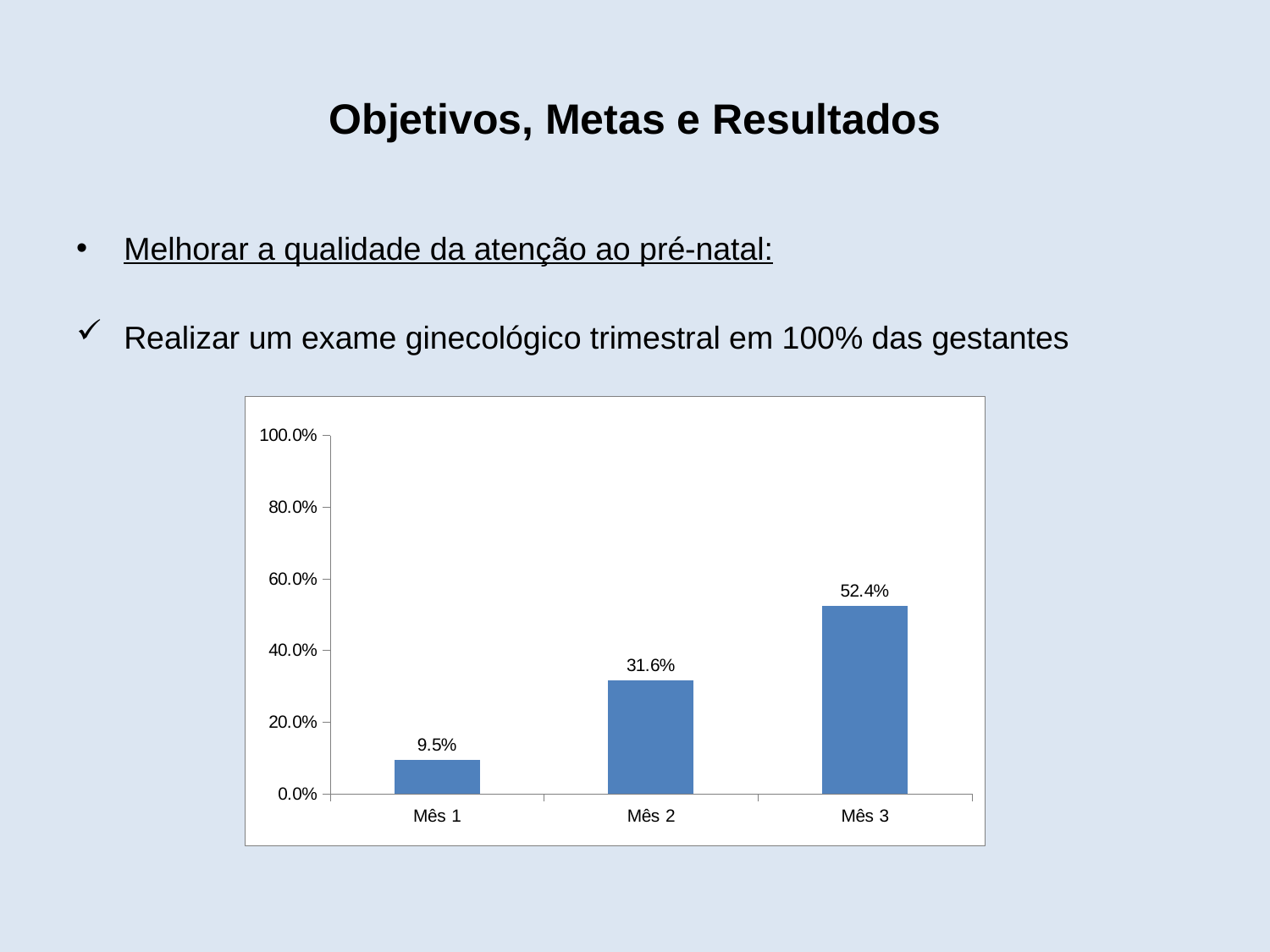
How many categories are shown on the x axis? 3 What is the difference between the values for Mês 2 and Mês 1? 22.1% Is the value for Mês 3 greater or less than 40.0%? greater Which month has the highest value? Mês 3 Do the values rise or fall from Mês 1 to Mês 3? rise What kind of chart is shown on the slide? bar chart What is the value for Mês 1? 9.5% What is the difference between the values for Mês 3 and Mês 2? 20.8% What is the value for Mês 3? 52.4% Which month has the lowest value? Mês 1 What is the value for Mês 2? 31.6% Which is larger, the value for Mês 1 or the value for Mês 2? Mês 2